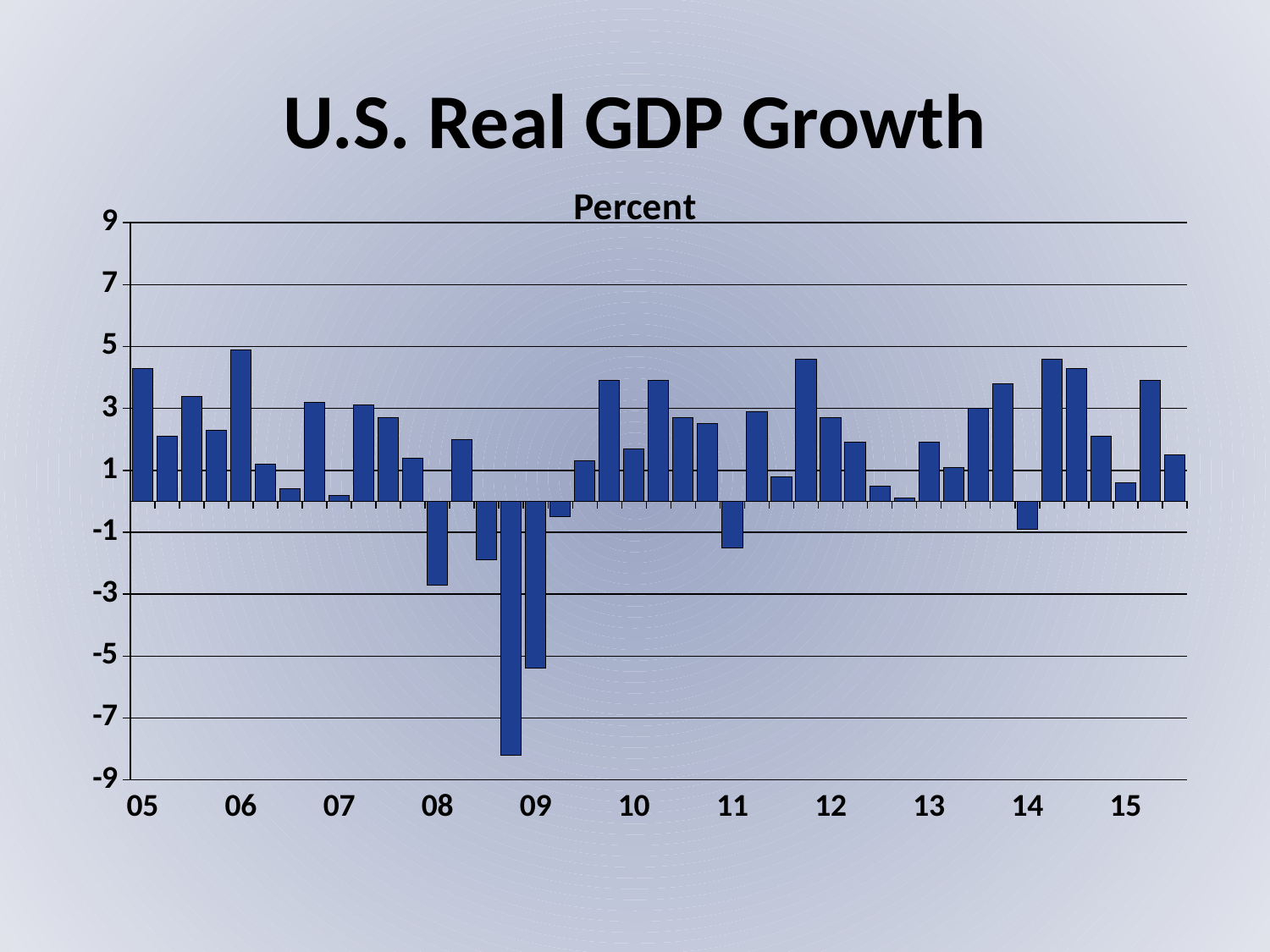
What unit label is shown above the vertical axis? Percent Is the value of the bar at the 12 label greater or less than 3? less Is the lowest bar on the chart greater or less than -7? less What is the title of the chart? U.S. Real GDP Growth Is the value of the bar at the 11 label greater or less than -1? less How many year labels are shown along the x axis? 11 What kind of chart is shown on the slide? bar chart Between the 08 label and the 09 label, do the bars generally rise or fall? fall Which is larger, the bar at the 05 label or the bar at the 07 label? 05 Which is larger, the bar at the 12 label or the bar at the 13 label? 12